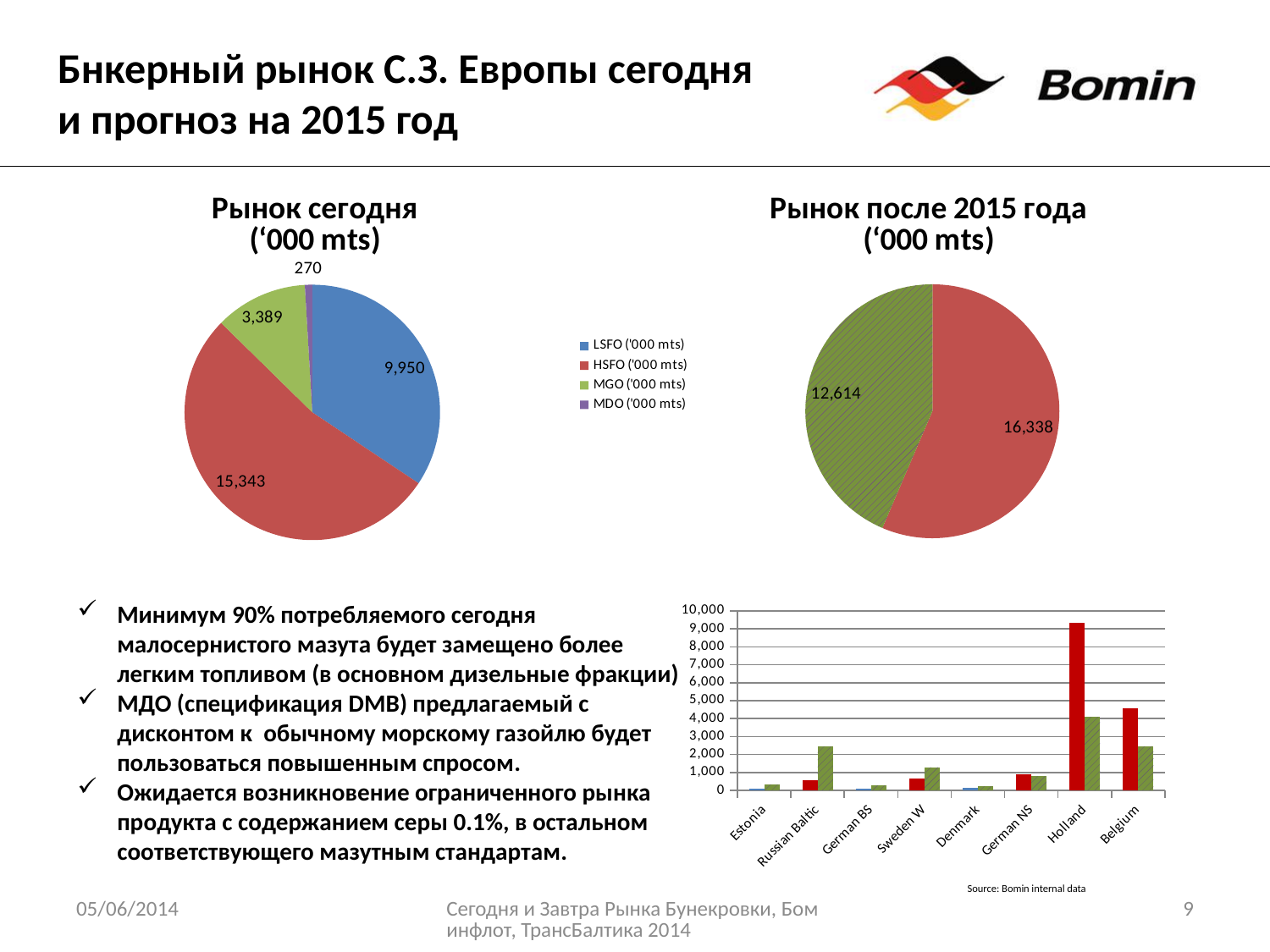
In the "Рынок сегодня ('000 mts)" chart, which category has the largest slice? HSFO ('000 mts) In the "Рынок сегодня ('000 mts)" chart, what is the difference between the HSFO and LSFO values? 5,393 In the "Рынок сегодня ('000 mts)" chart, what is the value for HSFO ('000 mts)? 15,343 In the "Рынок после 2015 года ('000 mts)" chart, what is the value of the larger (red) slice? 16,338 In the "Рынок сегодня ('000 mts)" chart, what is the value for MDO ('000 mts)? 270 How many categories are shown on the x axis of the bar chart at the bottom right of the slide? 8 What kind of chart is the "Рынок сегодня ('000 mts)" chart? pie chart How many entries does the legend of the "Рынок сегодня ('000 mts)" chart list? 4 In the "Рынок после 2015 года ('000 mts)" chart, what is the difference between the two slice values? 3,724 In the bar chart at the bottom right of the slide, is the red bar for Holland greater or less than 8,000? greater In the "Рынок сегодня ('000 mts)" chart, which category has the smallest slice? MDO ('000 mts) In the "Рынок сегодня ('000 mts)" chart, what is the value for LSFO ('000 mts)? 9,950